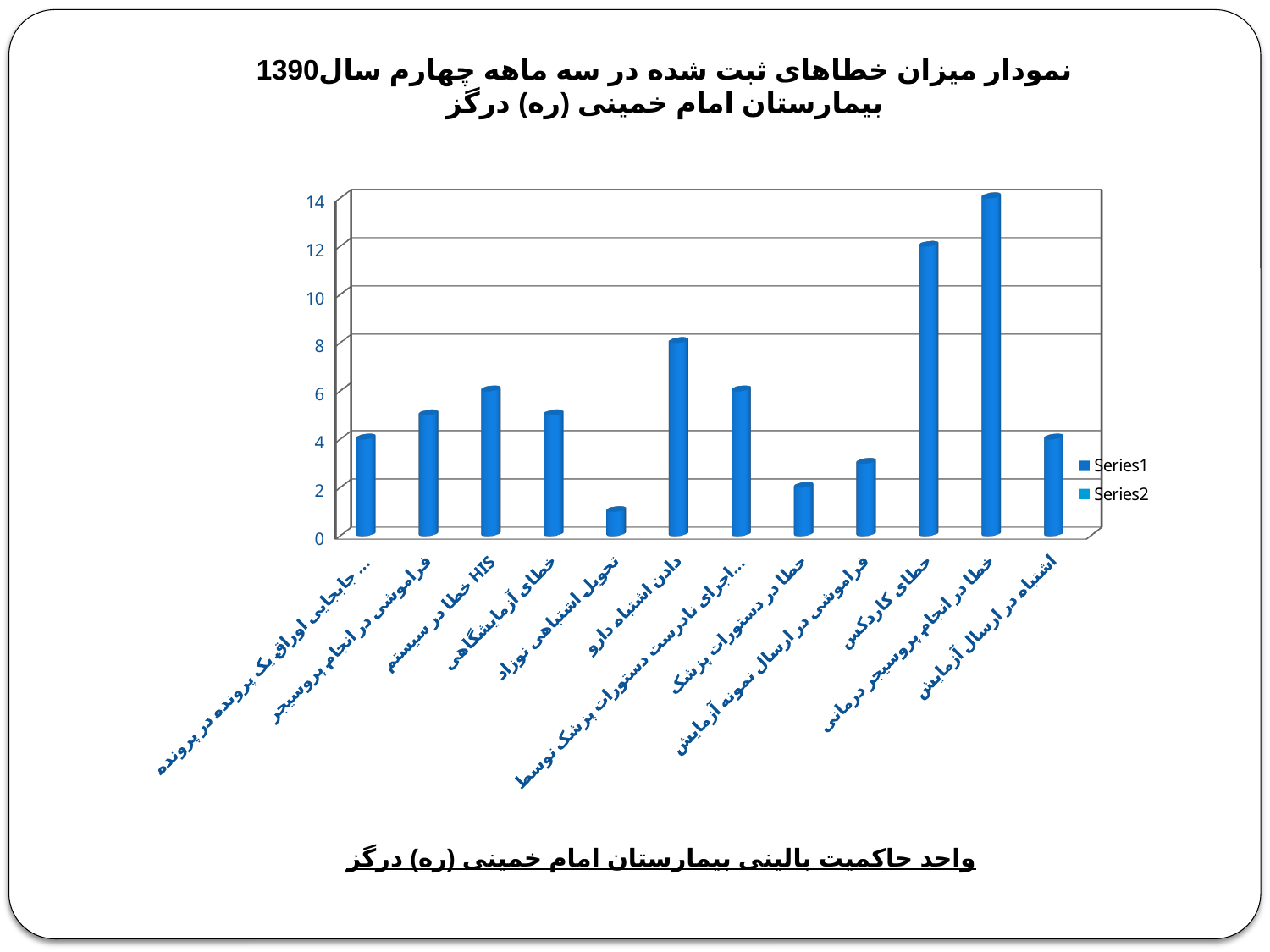
Which category has the highest value in the chart? خطا در انجام پروسیجر درمانی What is the difference between the values for خطا در انجام پروسیجر درمانی and خطای کاردکس? 2 Is the value for فراموشی در انجام پروسیجر greater or less than 4? greater What is the value for خطای کاردکس? 12 What is the value for خطا در انجام پروسیجر درمانی? 14 Which category has the lowest value in the chart? تحویل اشتباهی نوزاد How many categories are shown on the x axis of the chart? 12 How many series does the legend list? 2 What is the value for دادن اشتباه دارو? 8 Which is larger, the value for خطای کاردکس or the value for دادن اشتباه دارو? خطای کاردکس What type of chart is shown on the slide? bar chart What are the entries listed in the chart legend? Series1, Series2